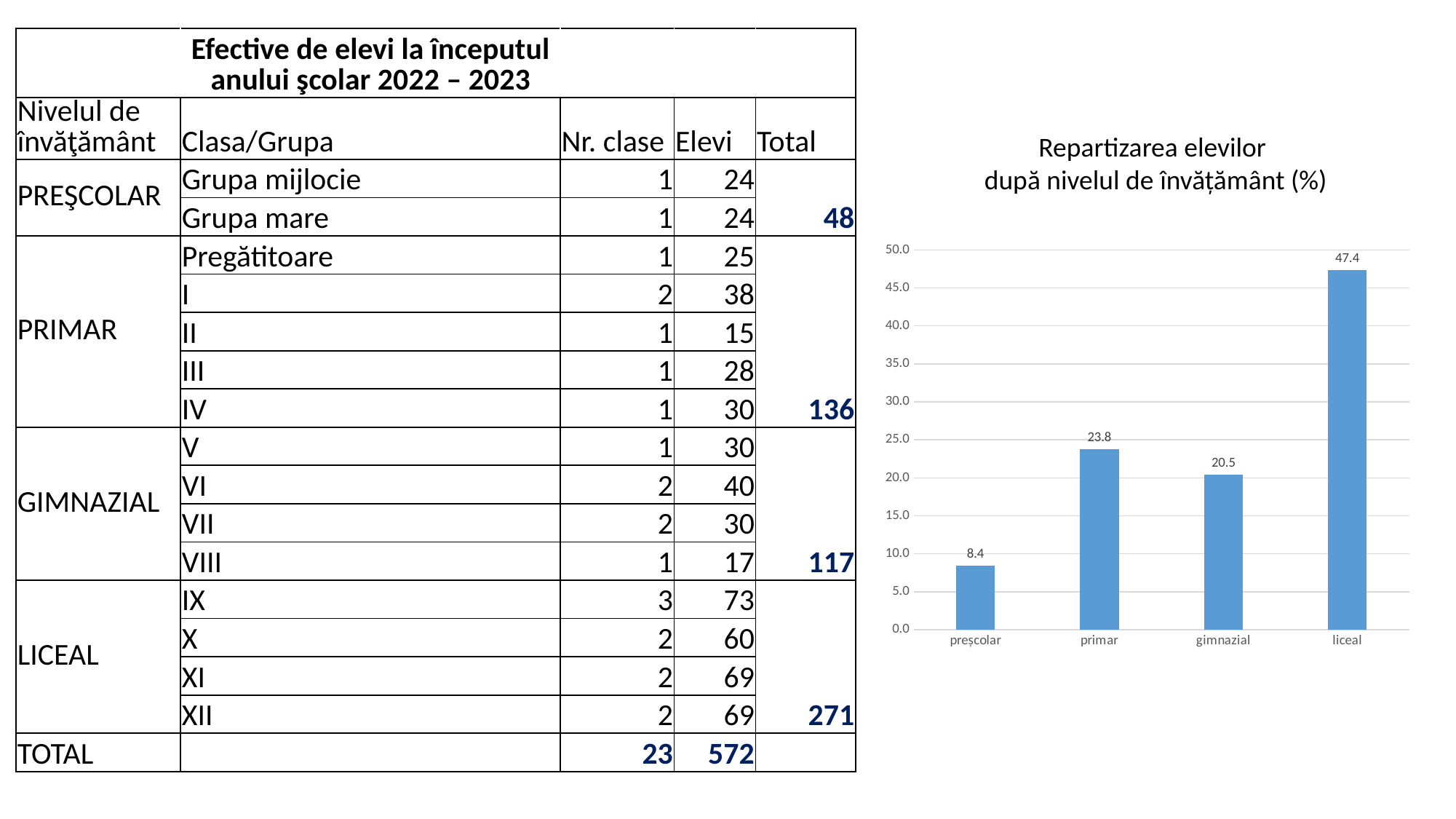
Which is larger, the value for primar or the value for gimnazial? primar What is the value for liceal in the chart? 47.4 What kind of chart is shown on the slide? bar chart What is the value for preșcolar in the chart? 8.4 What is the title of the chart? Repartizarea elevilor după nivelul de învățământ (%) Which category has the lowest value in the chart? preșcolar What is the value for gimnazial in the chart? 20.5 Which category has the highest value in the chart? liceal What is the value for primar in the chart? 23.8 Is the value for gimnazial greater or less than 25.0? less What is the difference between the values for liceal and primar? 23.6 How many categories are shown in the chart? 4